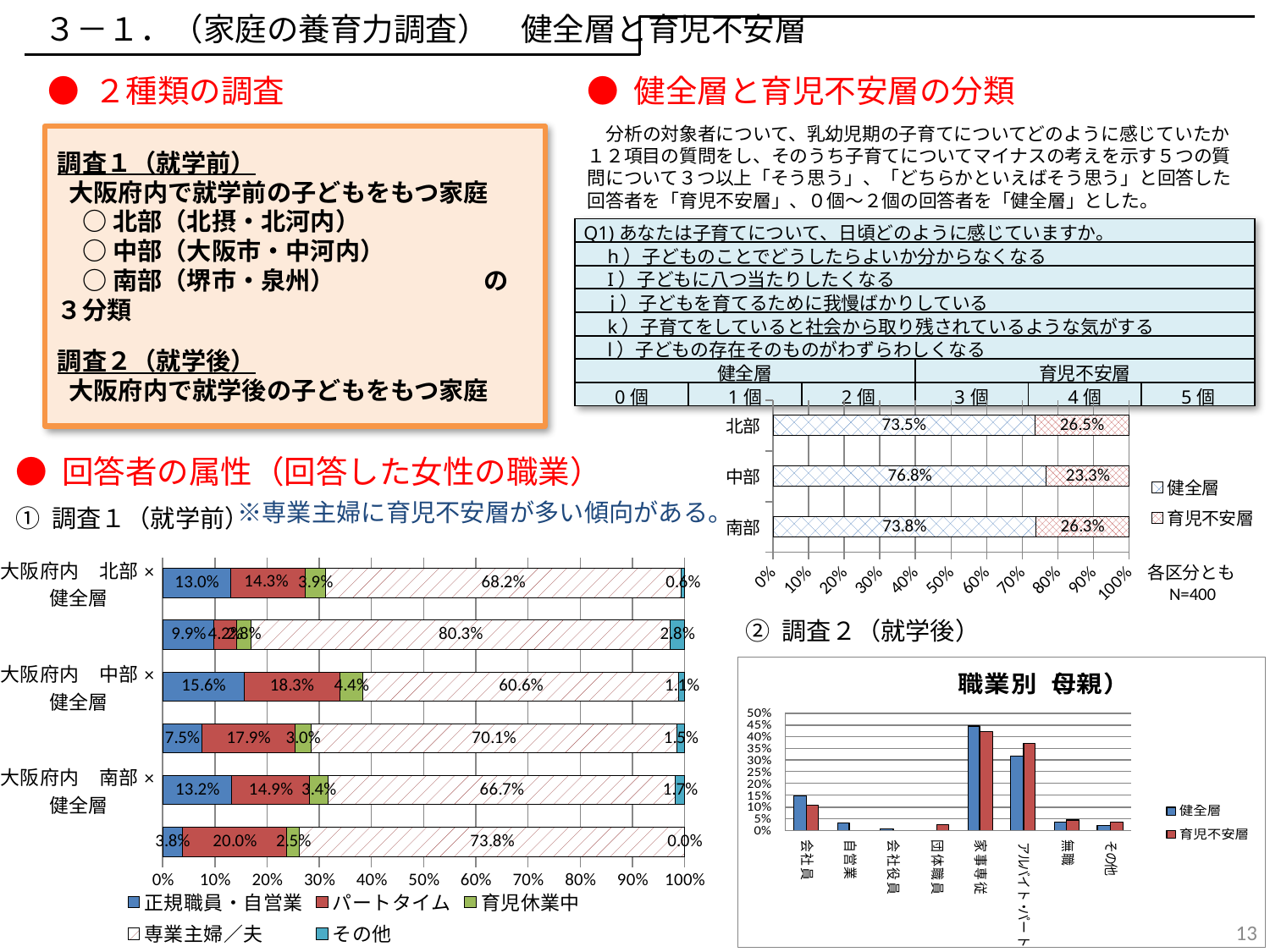
In the top-right chart of 健全層 and 育児不安層 by region, how many regions are plotted? 3 In the top-right chart of 健全層 and 育児不安層 by region, what is the value for 健全層 in 北部? 73.5% In the bottom-left chart for 調査1 (就学前), what is the value for 専業主婦／夫 in the 大阪府内 北部 × 健全層 bar? 68.2% What kind of chart is the bottom-right chart titled 職業別 母親)? bar chart In the top-right chart of 健全層 and 育児不安層 by region, what is the value for 育児不安層 in 中部? 23.3% In the bottom-right chart titled 職業別 母親), is the 健全層 value for 会社員 greater or less than 10%? greater In the top-right chart of 健全層 and 育児不安層 by region, what is the difference between 健全層 and 育児不安層 for 北部? 47.0% In the top-right chart of 健全層 and 育児不安層 by region, which region has the highest 健全層 share? 中部 In the bottom-left chart for 調査1 (就学前), which is larger, the 専業主婦／夫 value for 大阪府内 北部 × 健全層 or for 大阪府内 中部 × 健全層? 大阪府内 北部 × 健全層 In the bottom-left chart for 調査1 (就学前), how many series does the legend list? 5 In the bottom-left chart for 調査1 (就学前), what is the value for パートタイム in the 大阪府内 中部 × 健全層 bar? 18.3% In the bottom-right chart titled 職業別 母親), which occupation has the highest value for 健全層? 家事専従